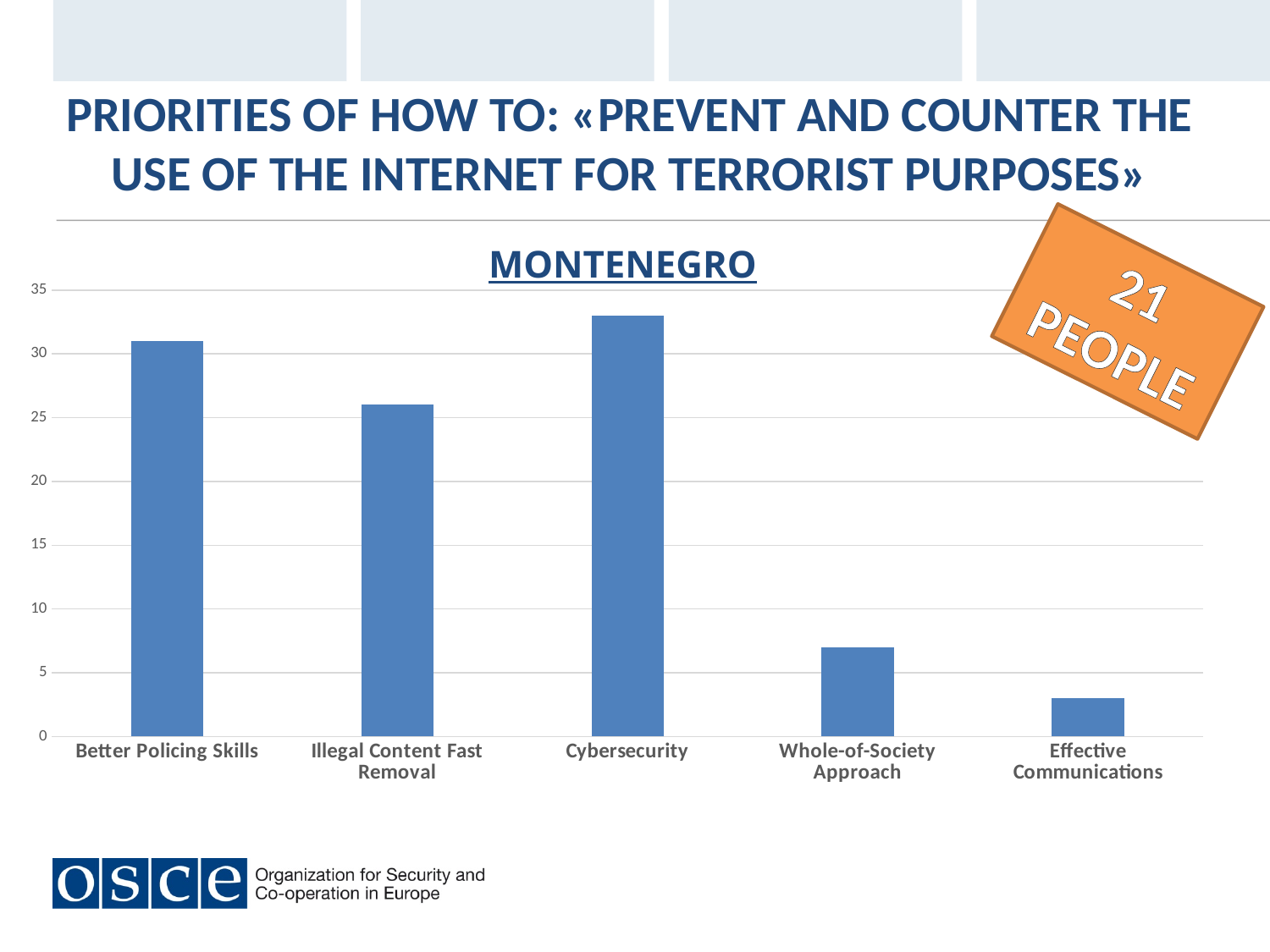
Which category has the highest bar in the chart? Cybersecurity Is the value for Cybersecurity greater or less than 30? greater Which is larger, the value for Better Policing Skills or the value for Illegal Content Fast Removal? Better Policing Skills What kind of chart is shown on the slide? bar chart Is the value for Better Policing Skills greater or less than 25? greater Which category has the lowest bar in the chart? Effective Communications Is the value for Illegal Content Fast Removal greater or less than 20? greater How many categories are shown on the x axis of the chart? 5 Which is larger, the value for Whole-of-Society Approach or the value for Effective Communications? Whole-of-Society Approach What is the title shown directly above the chart? MONTENEGRO